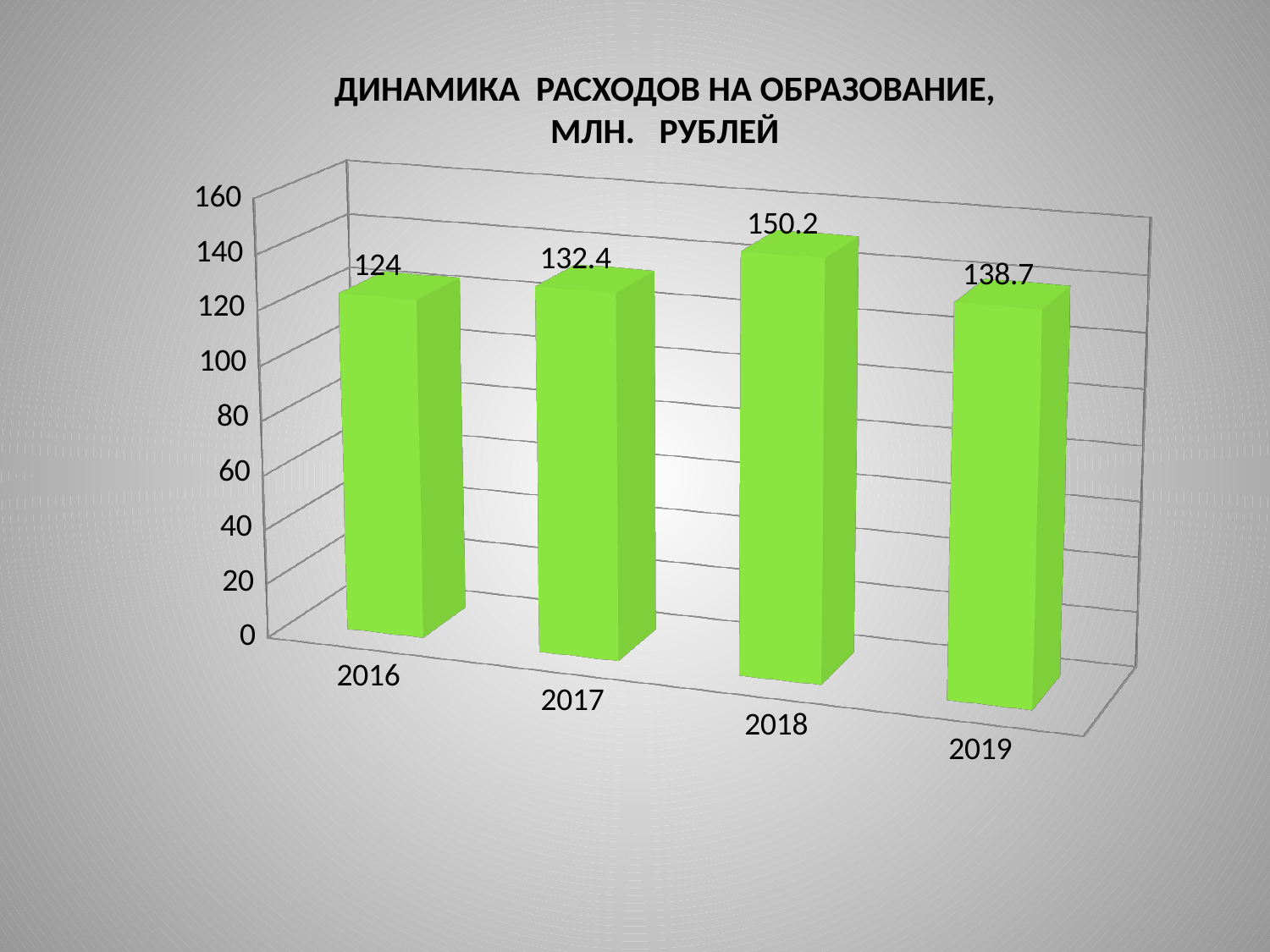
What is the value for 2016? 124 Which year has the lowest value? 2016 What is the difference between the values for 2018 and 2017? 17.8 Is the value for 2018 greater or less than 140? greater What is the title of the chart? ДИНАМИКА РАСХОДОВ НА ОБРАЗОВАНИЕ, МЛН. РУБЛЕЙ What is the value for 2018? 150.2 What kind of chart is shown on the slide? bar chart Which is larger, the value for 2017 or the value for 2019? 2019 What is the difference between the values for 2019 and 2016? 14.7 How many years are shown on the chart? 4 Which year has the highest value? 2018 What is the value for 2019? 138.7